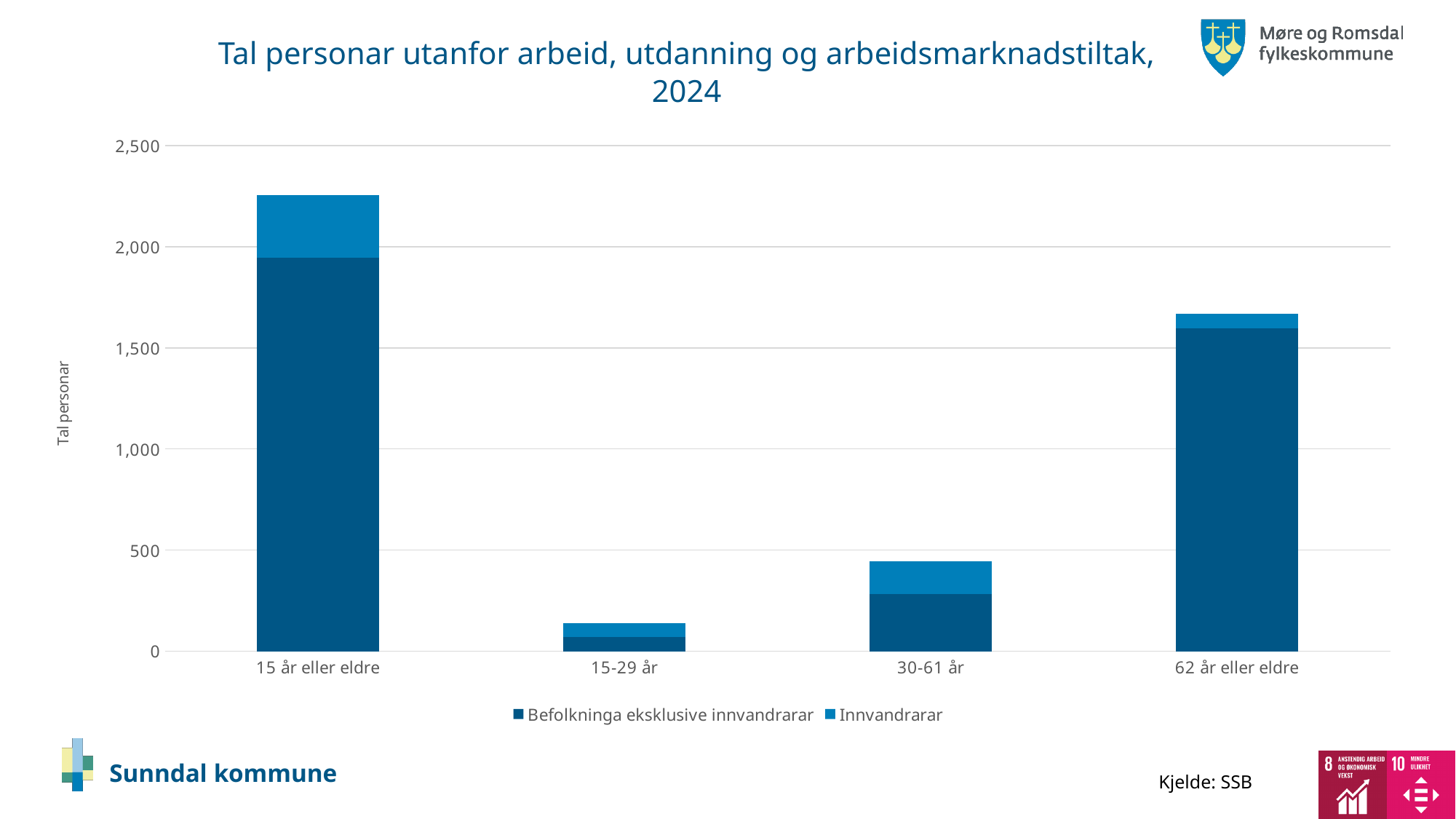
Is the total bar for 62 år eller eldre greater or less than 1,500? greater Which age category has the lowest total bar? 15-29 år What kind of chart is shown on the slide? Stacked bar chart Is the Befolkninga eksklusive innvandrarar value for 15 år eller eldre greater or less than 2,000? less How many series does the legend list? 2 Is the total bar for 15 år eller eldre greater or less than 2,000? greater How many age categories are shown on the x axis? 4 Which age category has the highest total bar? 15 år eller eldre What is the label on the y axis? Tal personar Which has the larger total bar, 30-61 år or 15-29 år? 30-61 år What are the two series named in the legend? Befolkninga eksklusive innvandrarar and Innvandrarar